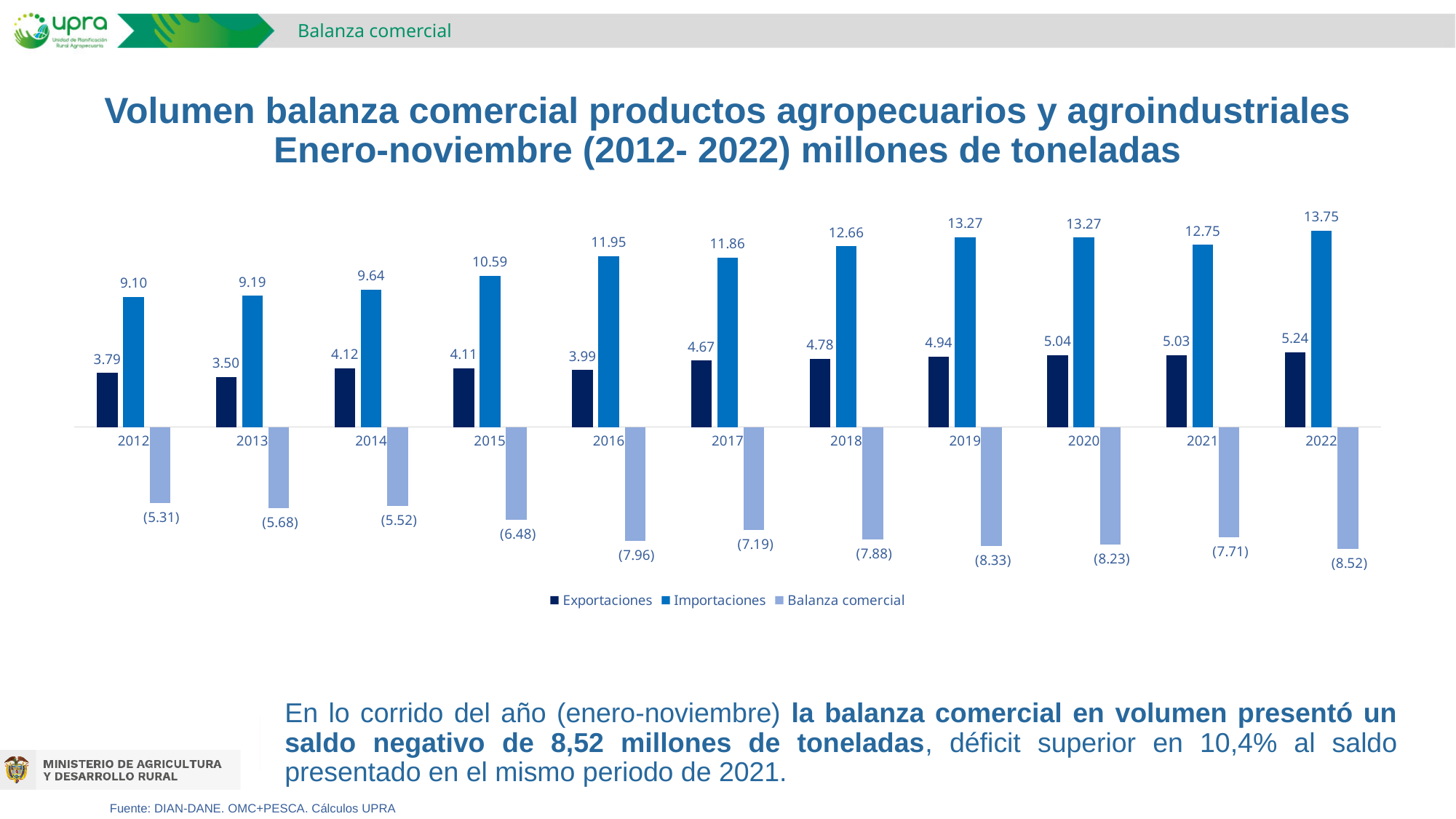
What is the value of Balanza comercial for 2022? (8.52) Which is larger, Exportaciones in 2019 or in 2018? 2019 How many years are shown on the x axis? 11 What is the value of Importaciones for 2016? 11.95 In which year is Importaciones highest? 2022 What is the difference between Exportaciones in 2022 and in 2012? 1.45 What is the difference between Importaciones in 2022 and in 2021? 1.00 In which year is Exportaciones lowest? 2013 What kind of chart is shown on the slide? Bar chart How many series does the legend list? 3 Do the Importaciones values rise or fall from 2012 to 2016? Rise What is the value of Exportaciones for 2013? 3.50